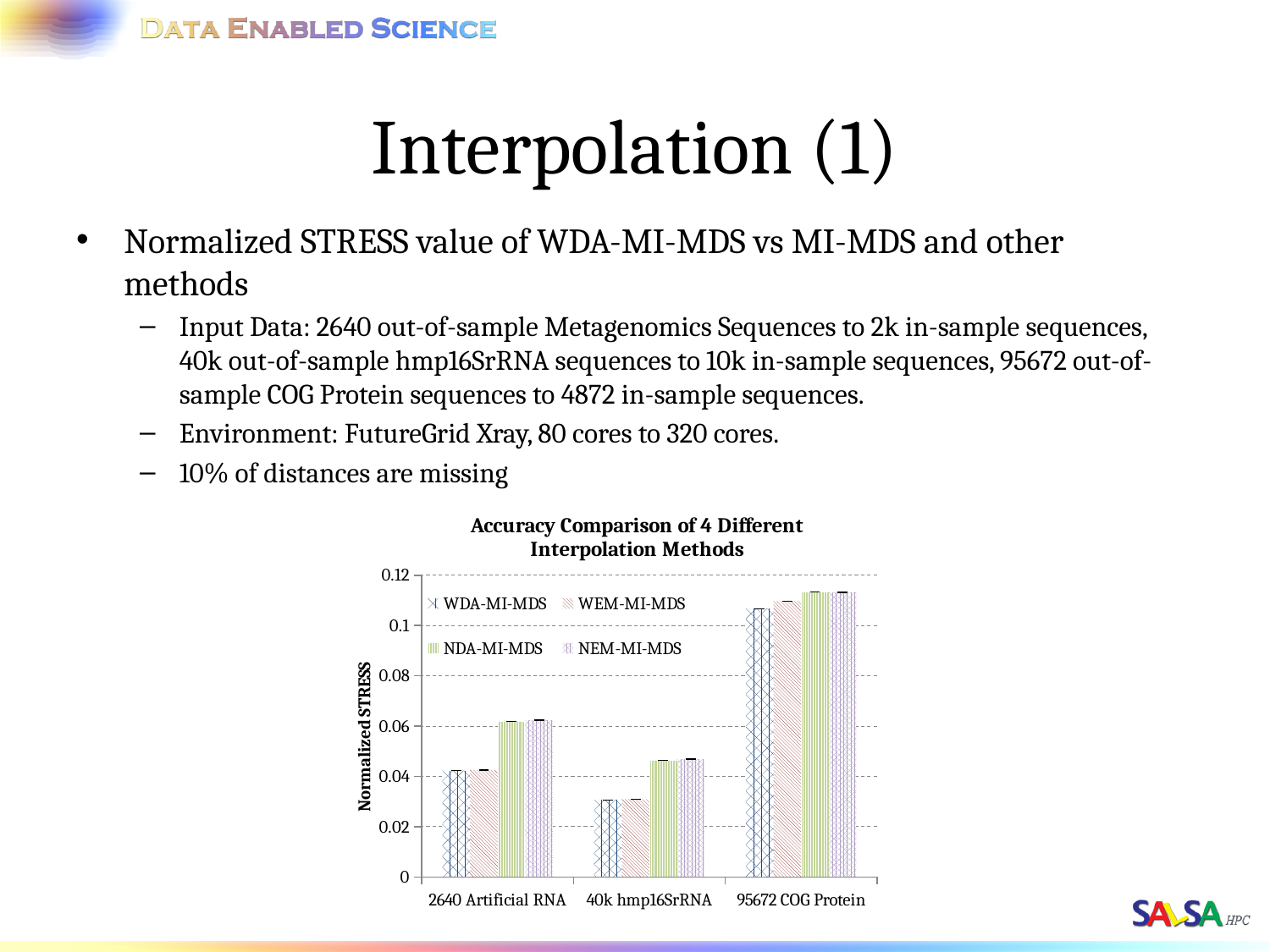
What is the title of the chart? Accuracy Comparison of 4 Different Interpolation Methods Is the WDA-MI-MDS value for 40k hmp16SrRNA greater or less than 0.04? less For 40k hmp16SrRNA, which is larger: the WDA-MI-MDS value or the NEM-MI-MDS value? NEM-MI-MDS What is the label of the vertical axis of the chart? Normalized STRESS For which category is the WDA-MI-MDS value lowest? 40k hmp16SrRNA Is the NDA-MI-MDS value for 2640 Artificial RNA greater or less than 0.08? less Is the WDA-MI-MDS value for 95672 COG Protein greater or less than 0.1? greater How many categories are shown along the x axis of the chart? 3 How many series does the chart's legend list? 4 For which category is the WDA-MI-MDS value highest? 95672 COG Protein For 2640 Artificial RNA, which is larger: the WDA-MI-MDS value or the NDA-MI-MDS value? NDA-MI-MDS What kind of chart is shown on the slide? Bar chart